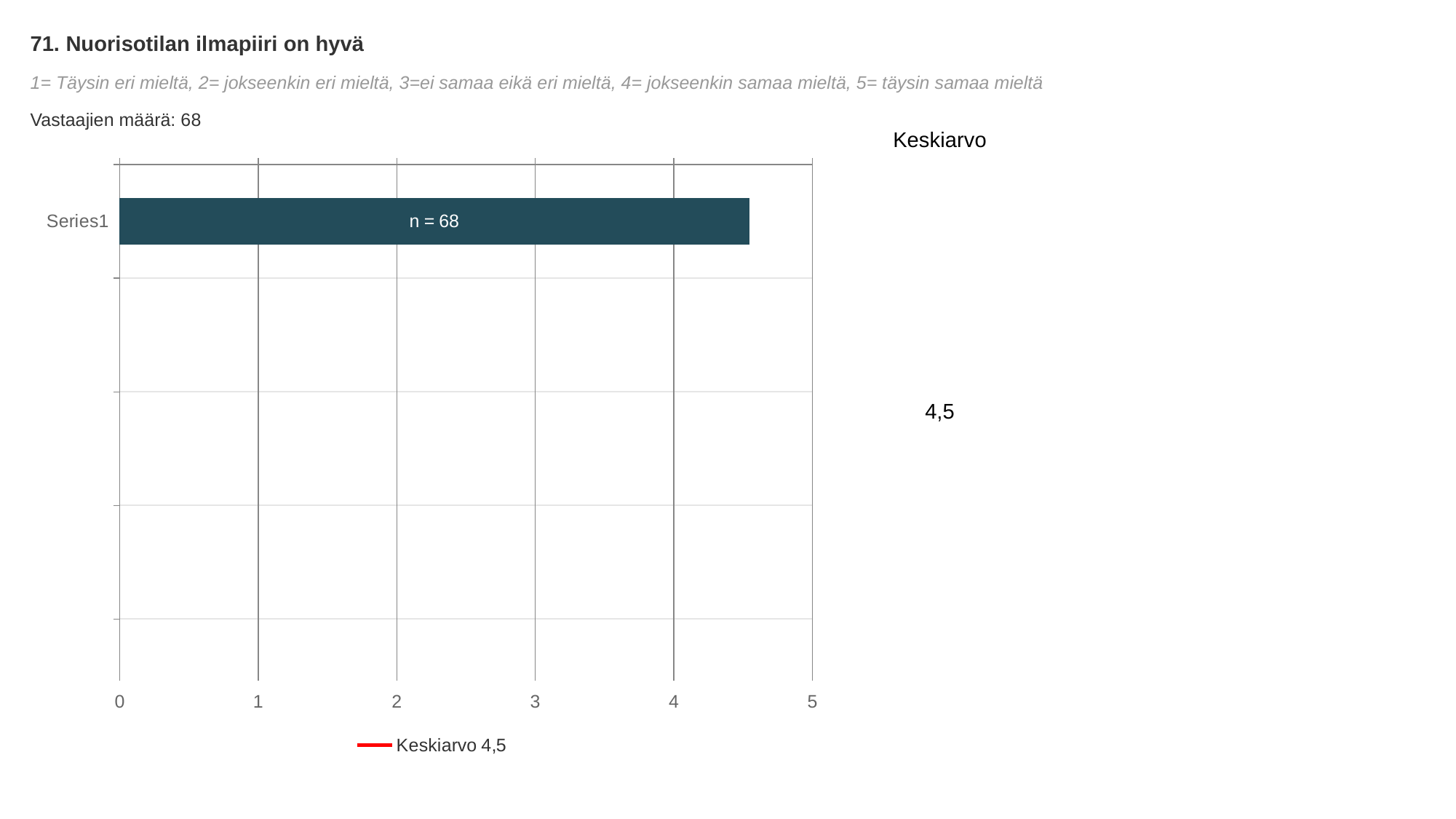
Is the value of the Series1 bar greater or less than 4? greater What does the legend entry below the chart say? Keskiarvo 4,5 Is the value of the Series1 bar greater or less than 5? less What is the highest value shown on the horizontal axis? 5 How many bars are plotted in the chart? 1 What kind of chart is shown on the slide? bar chart What is the Keskiarvo (mean) value shown on the slide? 4,5 What is the category label of the single bar? Series1 What is the number of respondents (Vastaajien määrä) stated on the slide? 68 What text label is printed on the bar? n = 68 Is the value of the Series1 bar greater or less than 3? greater